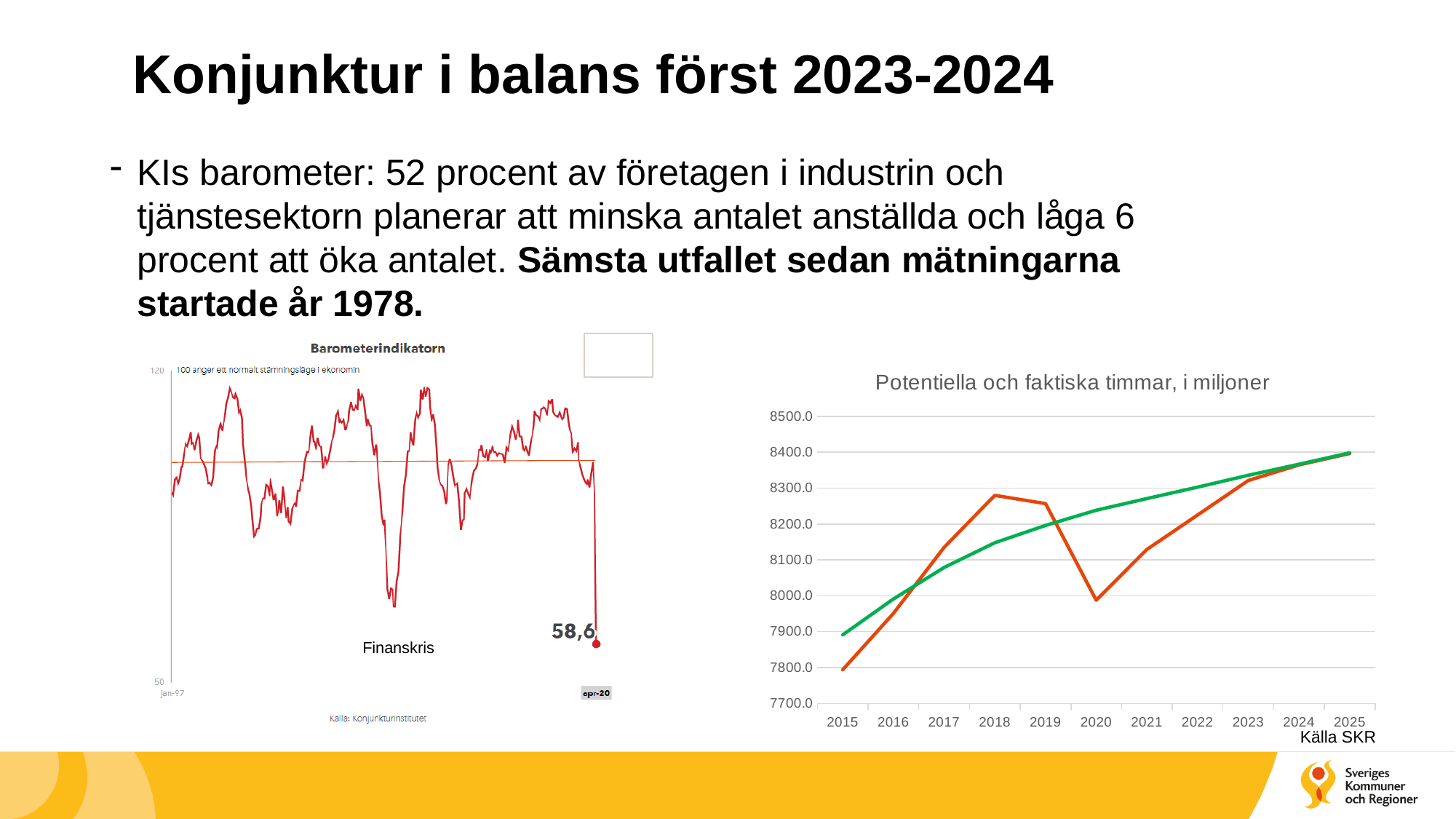
In the Barometerindikatorn chart, what is the highest value shown on the y axis? 120 In the 'Potentiella och faktiska timmar, i miljoner' chart, how many years are shown on the x axis? 11 In the 'Potentiella och faktiska timmar, i miljoner' chart, how many lines are plotted? 2 In the 'Potentiella och faktiska timmar, i miljoner' chart, is the orange line's value for 2018 greater or less than 8200.0? greater In the 'Potentiella och faktiska timmar, i miljoner' chart, does the green line rise or fall from 2015 to 2025? rise In the Barometerindikatorn chart, what event is annotated near the deep dip in the line? Finanskris What kind of chart is the 'Potentiella och faktiska timmar, i miljoner' chart on the right? line chart In the 'Potentiella och faktiska timmar, i miljoner' chart, is the orange line's value for 2020 greater or less than 8100.0? less In the 'Potentiella och faktiska timmar, i miljoner' chart, which line is higher in 2020, the green line or the orange line? the green line In the 'Potentiella och faktiska timmar, i miljoner' chart, is the orange line's value for 2015 greater or less than 7900.0? less What kind of chart is the Barometerindikatorn chart on the left? line chart In the Barometerindikatorn chart, what is the value printed at the last data point (apr-20)? 58,6